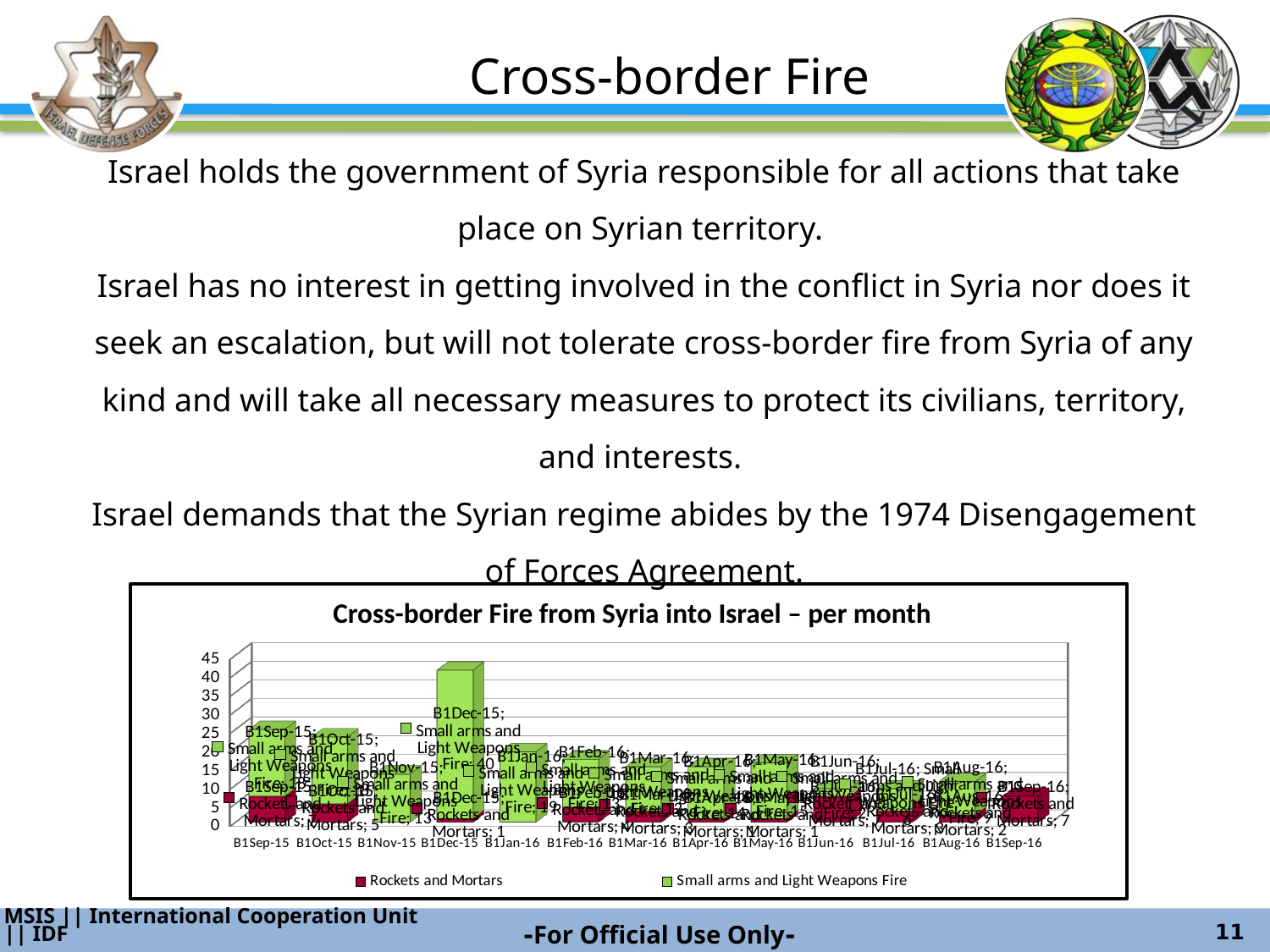
What is the highest value shown on the vertical axis of the chart? 45 What is the value of Small arms and Light Weapons Fire for B1Dec-15? 40 What are the two series named in the chart legend? Rockets and Mortars; Small arms and Light Weapons Fire What is the title of the chart? Cross-border Fire from Syria into Israel – per month What type of chart is shown on the slide? bar chart How many months (categories) are shown on the x axis of the chart? 13 Which month has the highest value for Small arms and Light Weapons Fire? B1Dec-15 Which is larger: Small arms and Light Weapons Fire for B1Dec-15 or for B1Sep-15? B1Dec-15 How many series does the chart legend list? 2 What is the value of Rockets and Mortars for B1Aug-16? 2 Is the Small arms and Light Weapons Fire value for B1Dec-15 greater or less than 30? greater What is the value of Rockets and Mortars for B1Sep-16? 7